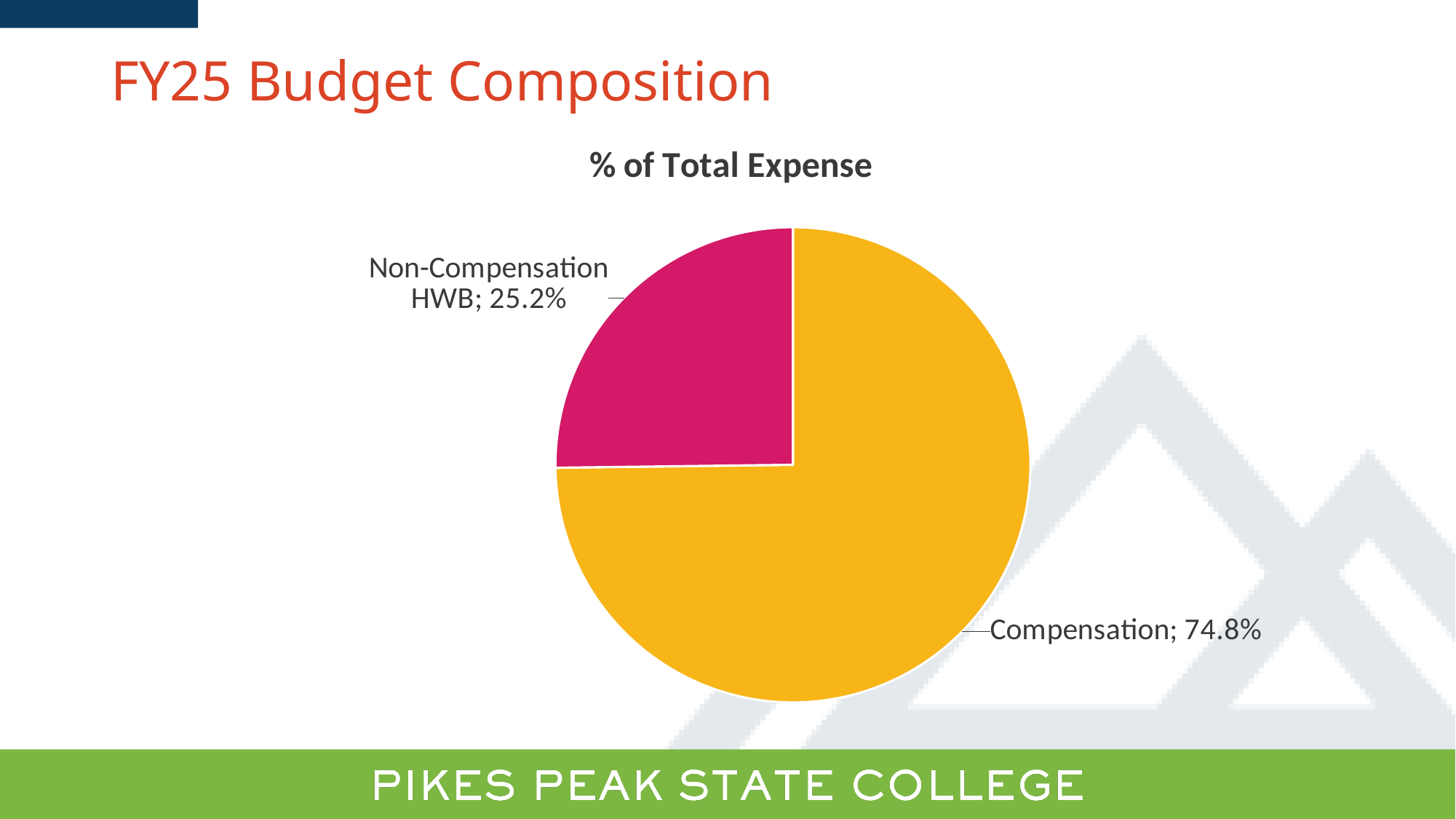
What is the difference in percentage points between Compensation and Non-Compensation HWB? 49.6 Which slice of the pie is the largest? Compensation Which is larger, Compensation or Non-Compensation HWB? Compensation What is the combined share of Compensation and Non-Compensation HWB? 100% What is the title of the chart? % of Total Expense How many slices does the pie chart have? 2 What colour is the Compensation slice? Yellow Which slice of the pie is the smallest? Non-Compensation HWB What percentage of total expense is Non-Compensation HWB? 25.2% What kind of chart is shown on the slide? Pie chart What percentage of total expense is Compensation? 74.8%